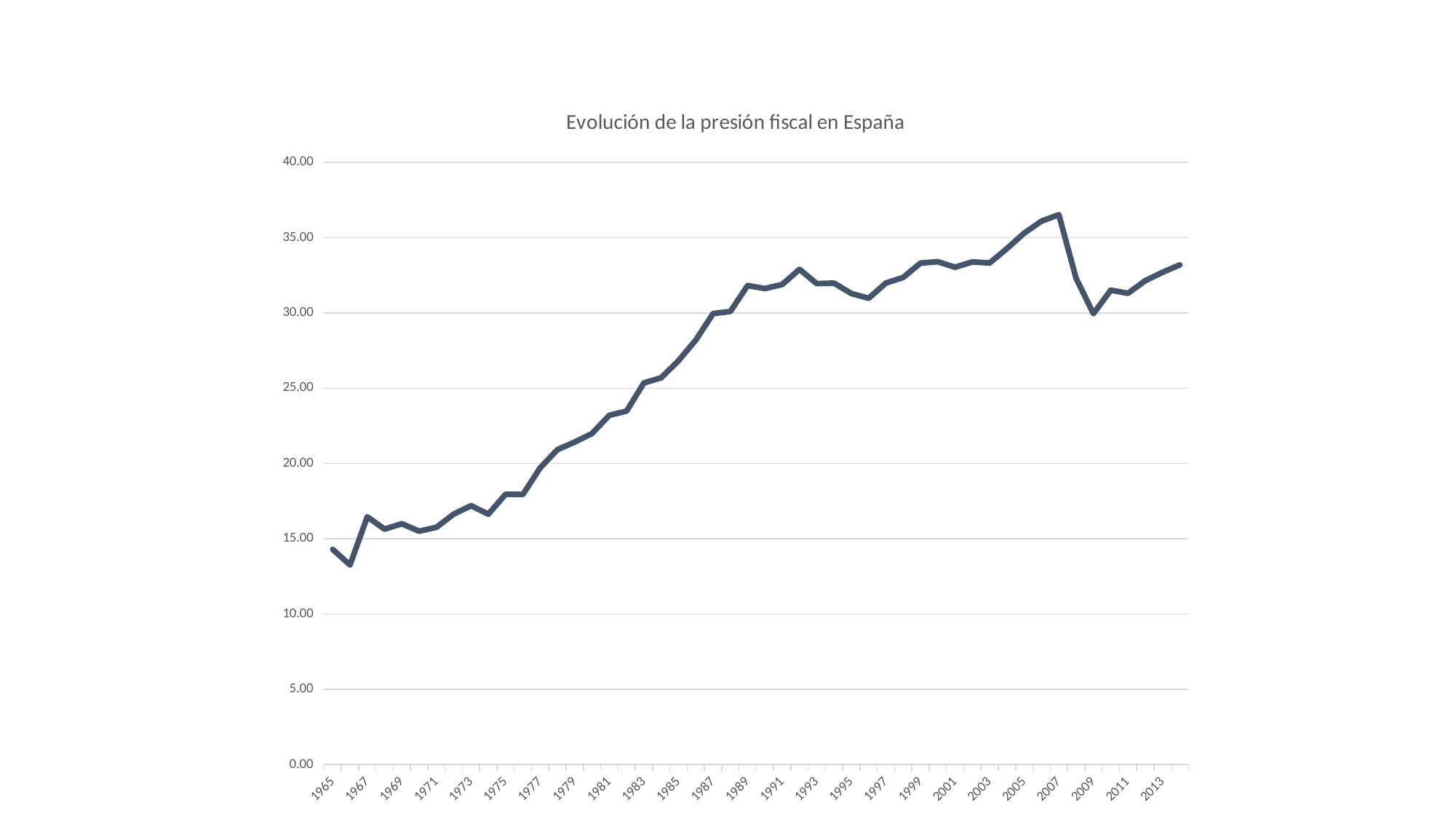
What kind of chart is shown on the slide? line chart Which year has the larger value, 2007 or 2009? 2007 Is the value for 2009 greater or less than 35.00? less What is the title of the chart? Evolución de la presión fiscal en España Is the value for 1966 greater or less than 15.00? less Is the value for 1991 greater or less than 30.00? greater In which year does the line reach its lowest value? 1966 In which year does the line reach its highest value? 2007 Overall, do the values rise or fall from 1965 to 2013? rise Which year has the larger value, 1965 or 1985? 1985